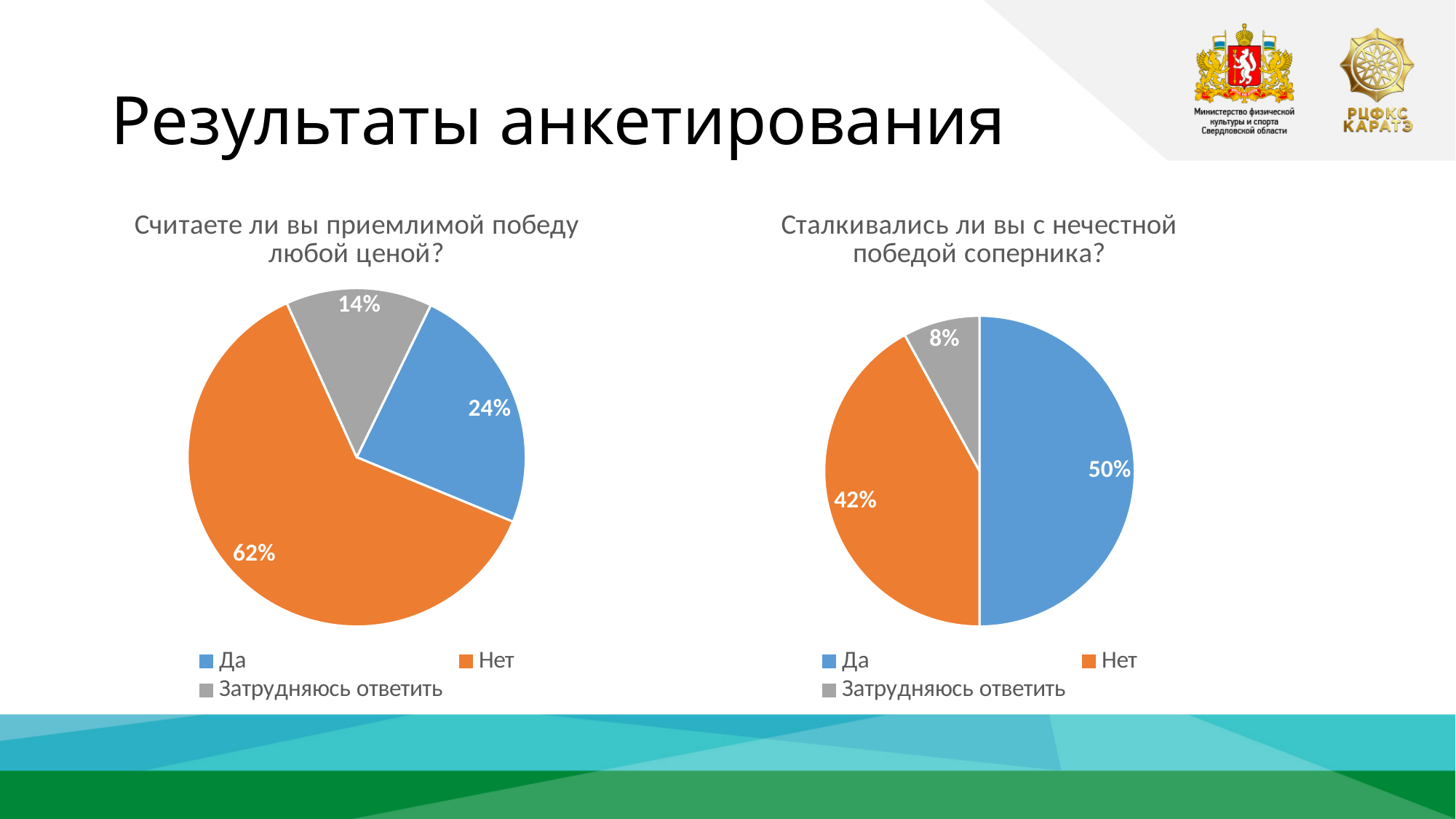
In the right chart "Сталкивались ли вы с нечестной победой соперника?", what share answered "Нет"? 42% How many categories does the legend of the right chart "Сталкивались ли вы с нечестной победой соперника?" list? 3 In the left chart "Считаете ли вы приемлимой победу любой ценой?", what share of respondents answered "Да"? 24% In the right chart "Сталкивались ли вы с нечестной победой соперника?", what share of respondents answered "Да"? 50% In the right chart "Сталкивались ли вы с нечестной победой соперника?", what share answered "Затрудняюсь ответить"? 8% In the left chart "Считаете ли вы приемлимой победу любой ценой?", what is the difference in percentage points between "Нет" and "Да"? 38 In the left chart "Считаете ли вы приемлимой победу любой ценой?", which answer has the largest share? Нет In the left chart "Считаете ли вы приемлимой победу любой ценой?", what share answered "Затрудняюсь ответить"? 14% In the right chart "Сталкивались ли вы с нечестной победой соперника?", which is larger: the share for "Да" or for "Нет"? Да In the left chart "Считаете ли вы приемлимой победу любой ценой?", what share of respondents answered "Нет"? 62% In the right chart "Сталкивались ли вы с нечестной победой соперника?", which answer has the smallest share? Затрудняюсь ответить What type of chart is the left chart "Считаете ли вы приемлимой победу любой ценой?"? Pie chart